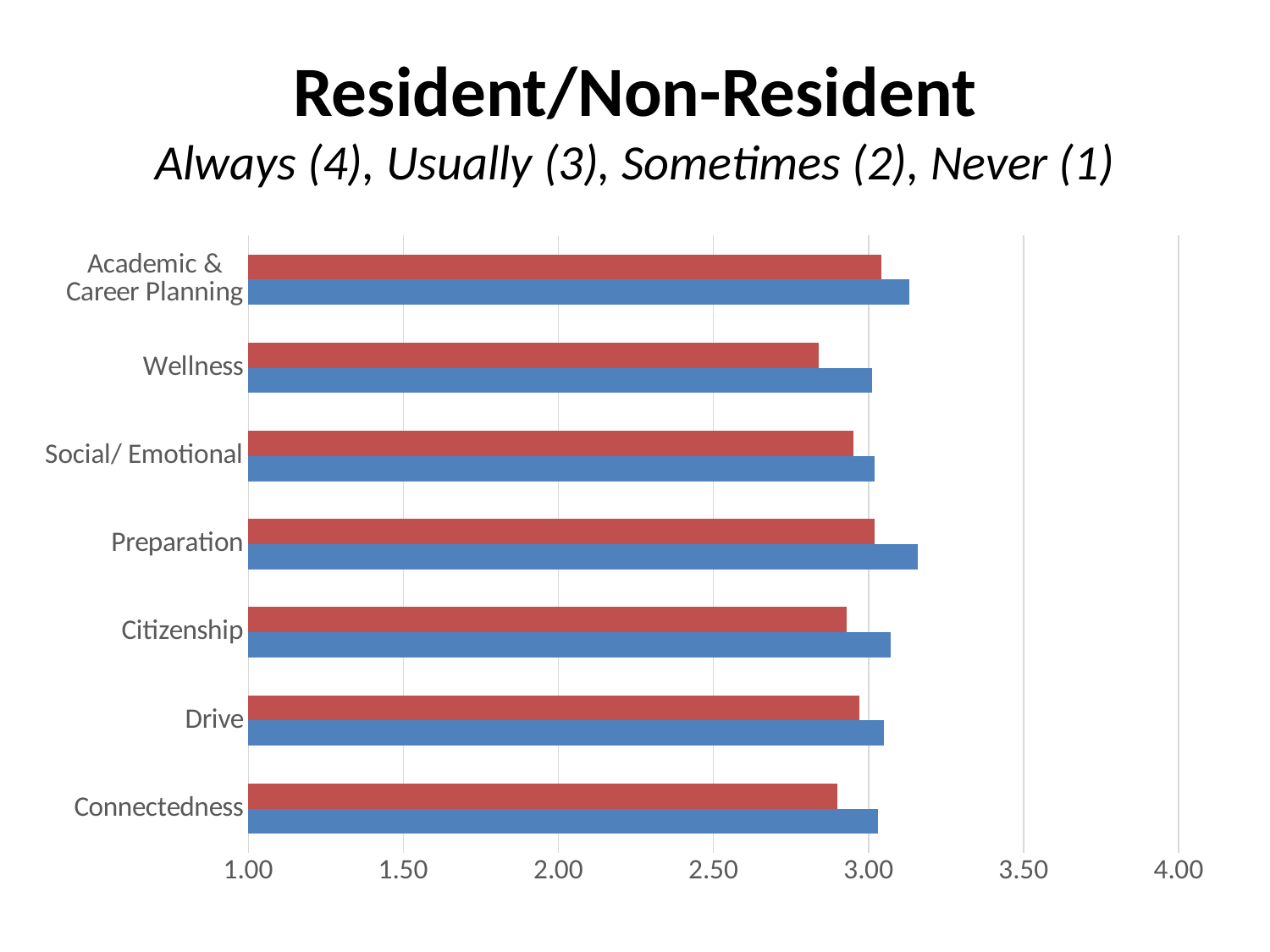
Is the blue bar for Preparation greater or less than 3.00? greater Is the red bar for Citizenship greater or less than 2.50? greater What is the maximum value shown on the horizontal axis of the chart? 4.00 Is the red bar for Wellness greater or less than 3.00? less For Preparation, which bar is longer, the red bar or the blue bar? the blue bar For Wellness, which bar is longer, the red bar or the blue bar? the blue bar What is the title of the chart on the slide? Resident/Non-Resident How many bars are plotted for each category in the chart? 2 What kind of chart is shown on the slide? bar chart How many categories are shown on the vertical axis of the chart? 7